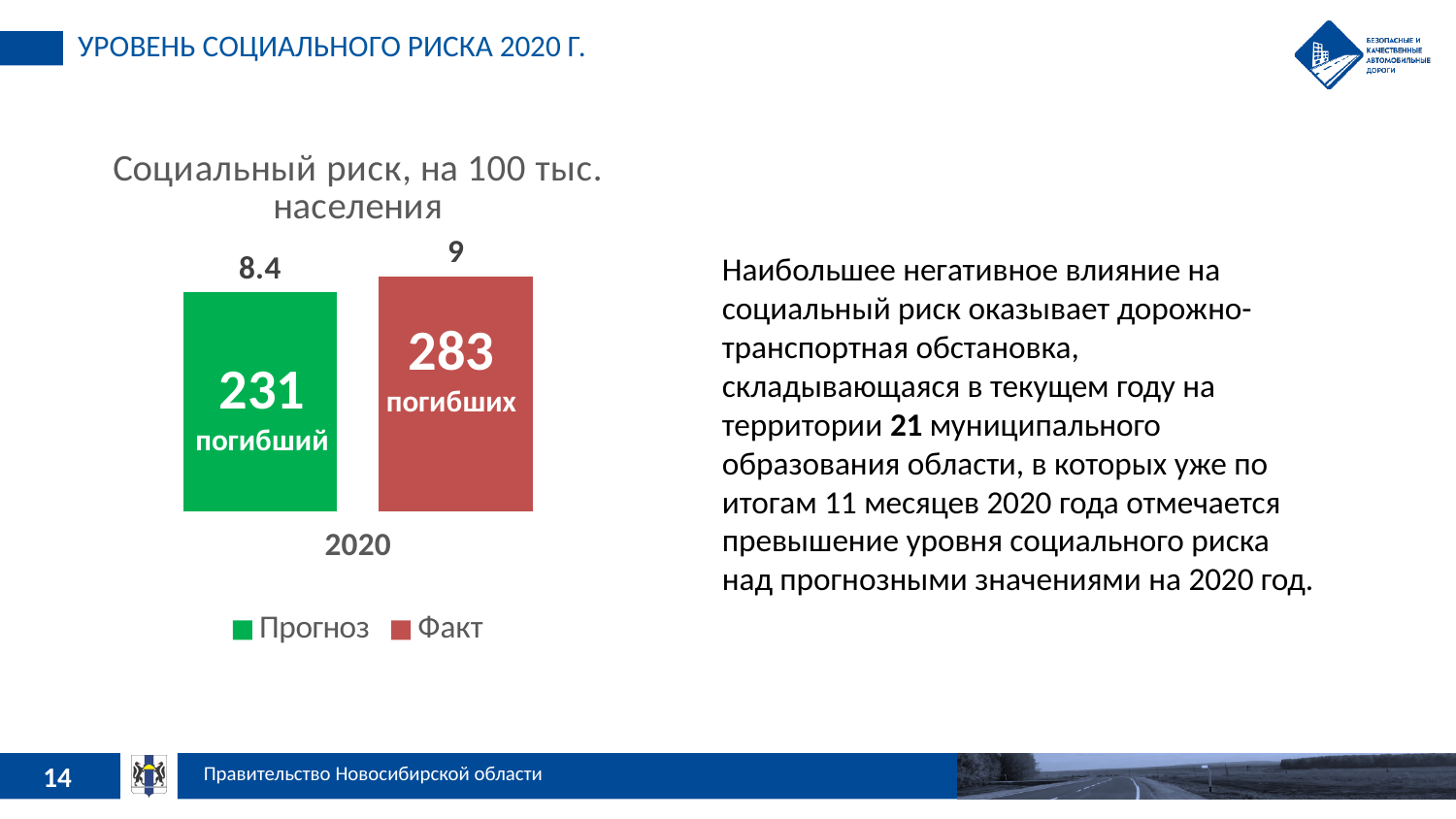
What number of deaths is written inside the Факт bar? 283 погибших What colour is the Факт bar in the chart? Red What is the difference between the Факт and Прогноз values for 2020? 0.6 What is the value of the Факт series for 2020 in the chart "Социальный риск, на 100 тыс. населения"? 9 What kind of chart is shown on the slide? Bar chart How many categories are shown on the x axis of the chart? 1 How many series does the chart legend list? 2 Which series has the higher value for 2020, Прогноз or Факт? Факт Which series has the lowest value in the chart? Прогноз What is the title of the chart? Социальный риск, на 100 тыс. населения What number of deaths is written inside the Прогноз bar? 231 погибший What is the value of the Прогноз series for 2020 in the chart "Социальный риск, на 100 тыс. населения"? 8.4